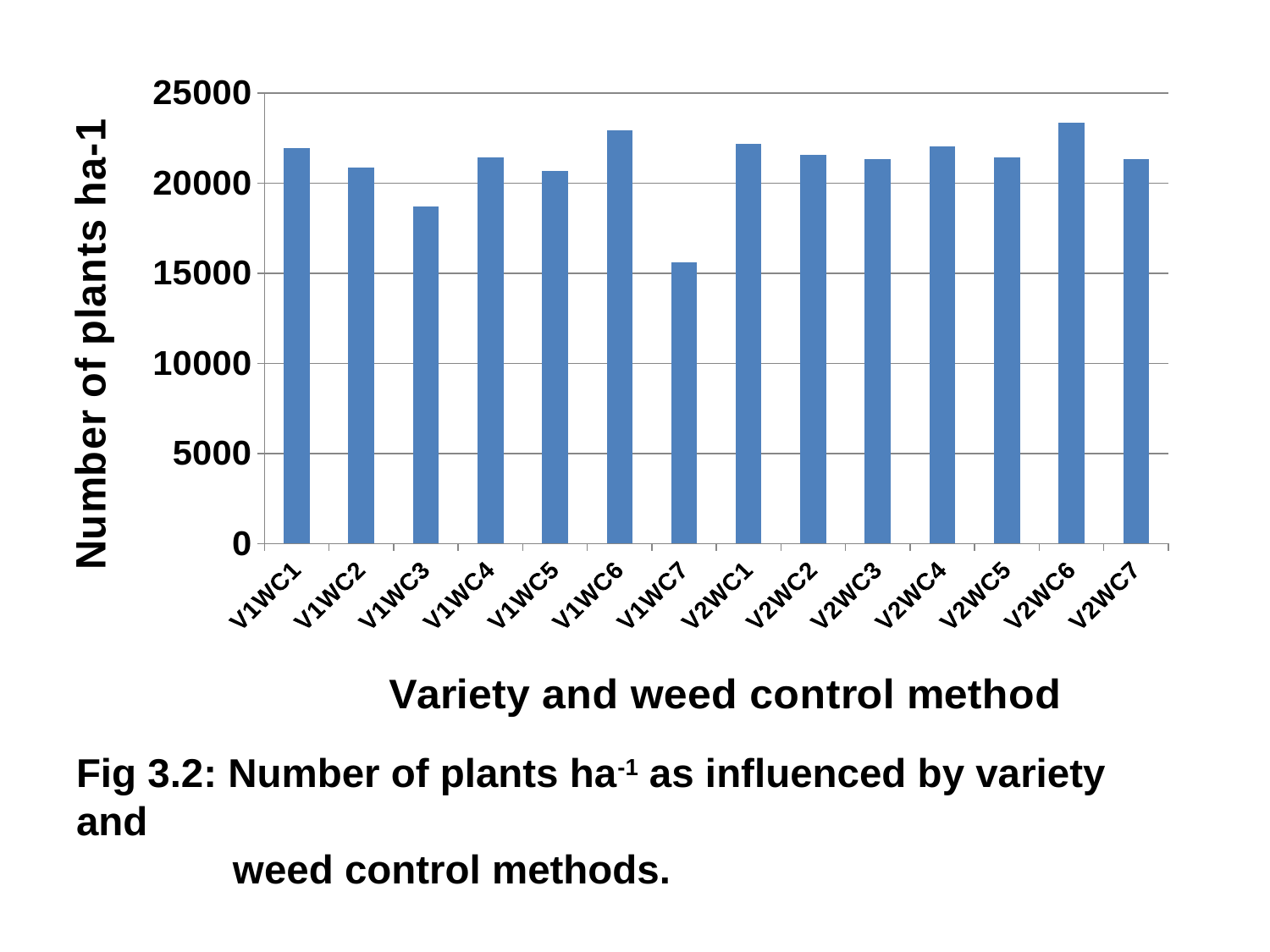
Which category has the lowest number of plants ha-1? V1WC7 Which is larger, the value for V1WC6 or the value for V1WC7? V1WC6 What kind of chart is shown on the slide? bar chart Is the value for V1WC7 greater or less than 20000? less What is the title of the y axis? Number of plants ha-1 Is the value for V1WC3 greater or less than 15000? greater Is the value for V2WC6 greater or less than 20000? greater How many categories are plotted along the x axis? 14 Which is larger, the value for V1WC3 or the value for V1WC7? V1WC3 What is the title of the x axis? Variety and weed control method